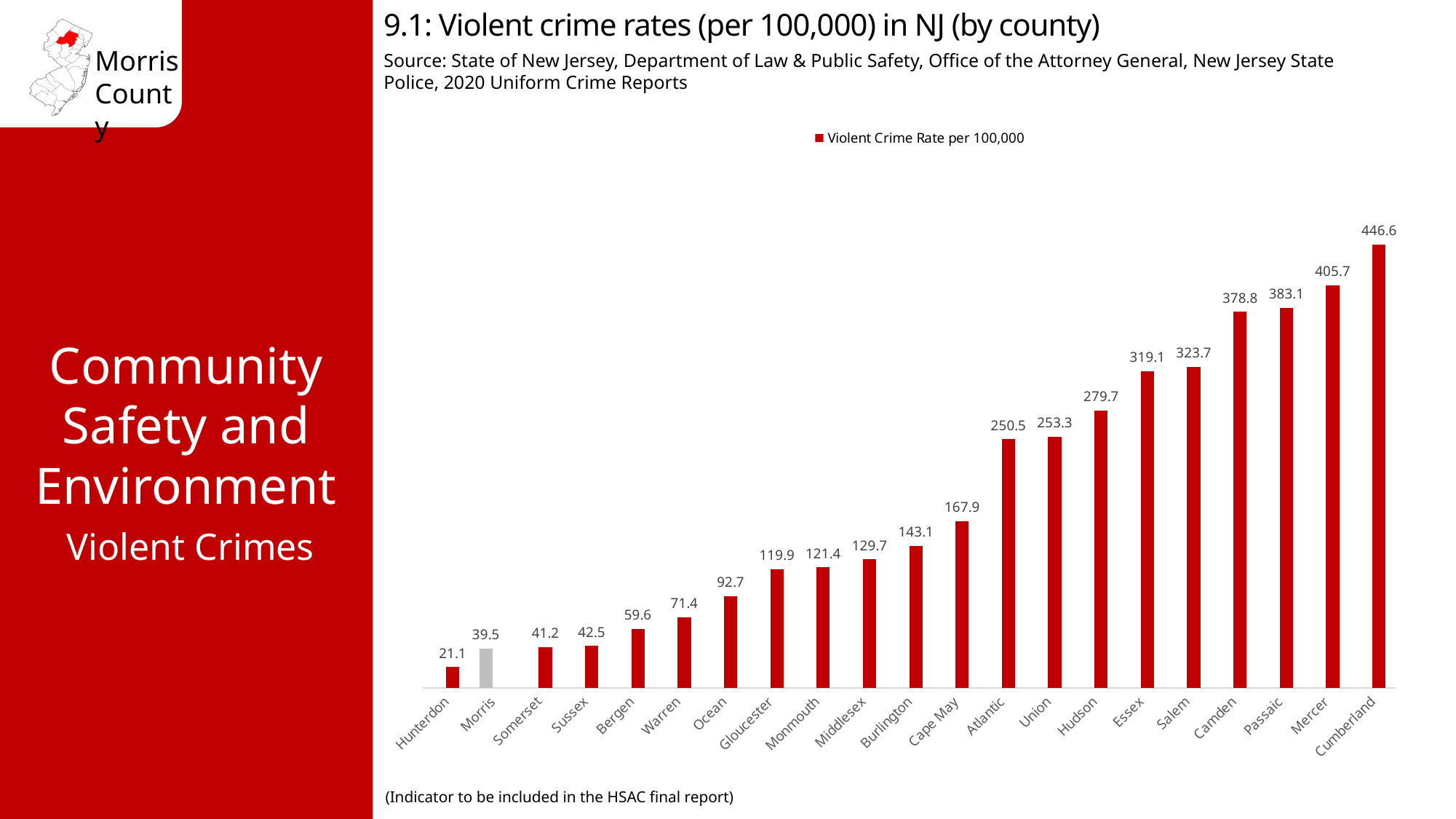
How many counties are shown on the chart? 21 What kind of chart is shown on the slide? Bar chart Which county has the highest violent crime rate? Cumberland What is the violent crime rate per 100,000 for Morris county? 39.5 What is the difference between the violent crime rates of Cumberland and Hunterdon? 425.5 Do the values rise or fall from left to right along the x axis? Rise What is the violent crime rate per 100,000 for Hudson county? 279.7 How many series does the legend list? 1 What is the violent crime rate per 100,000 for Cape May county? 167.9 Which county has the lowest violent crime rate? Hunterdon What is the difference between the violent crime rates of Morris and Hunterdon? 18.4 Which county has a higher violent crime rate, Essex or Atlantic? Essex